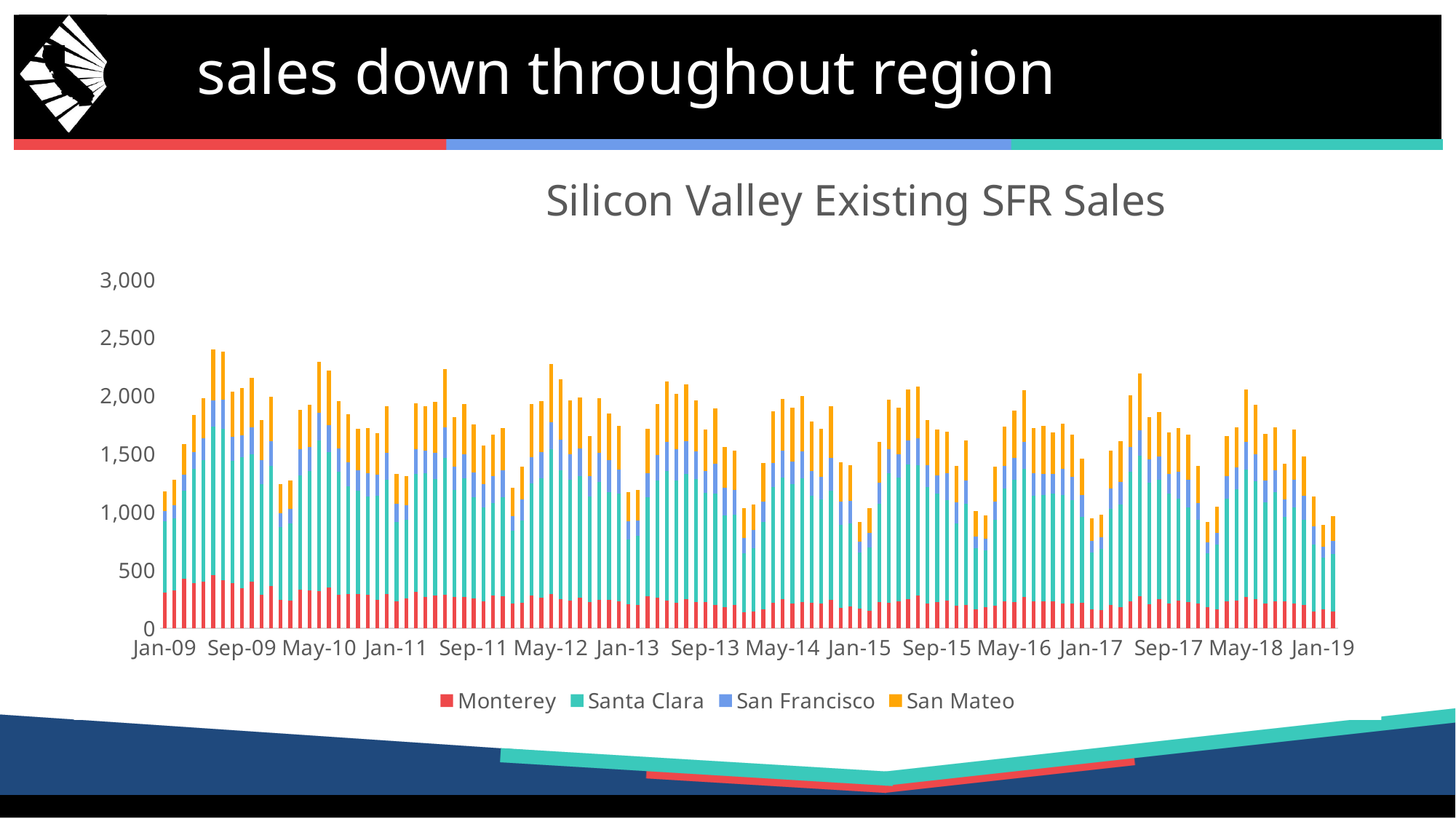
What is the highest value shown on the y axis? 3,000 Does any month's total bar exceed 2,500 on the chart? no How many series does the legend of the Silicon Valley Existing SFR Sales chart list? 4 Which series is shown in red in the chart? Monterey What is the last month labelled on the x axis? Jan-19 Is the total value for Jan-19 greater or less than 1,500? less Which series generally forms the largest segment of each stacked bar? Santa Clara What is the title of the chart? Silicon Valley Existing SFR Sales Is the total value for Jan-09 greater or less than 1,500? less In Jan-09, which segment is larger: Santa Clara or Monterey? Santa Clara What kind of chart is shown on the slide? stacked bar chart Do the total sales rise or fall over the final months of the chart leading up to Jan-19? fall